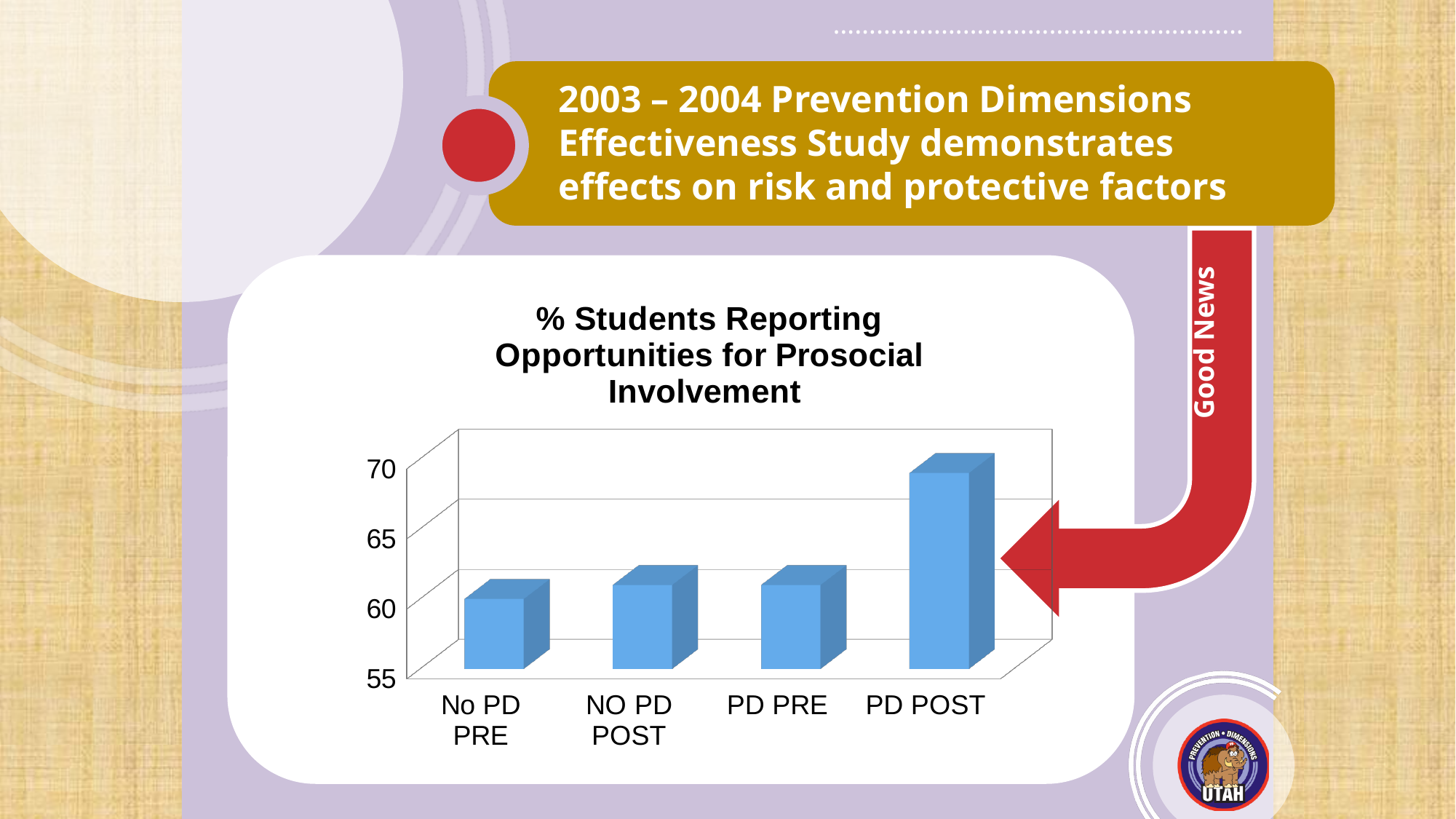
Which category has the lowest value in the chart? No PD PRE Which category has the highest value in the chart? PD POST How many categories are plotted on the x axis of the chart? 4 What kind of chart is shown on the slide? bar chart Is the value for No PD PRE greater or less than 65? less Which is larger, the value for PD POST or the value for PD PRE? PD POST What is the lowest value shown on the chart's vertical axis? 55 Is the value for NO PD POST greater or less than 55? greater Which is larger, the value for No PD PRE or the value for NO PD POST? NO PD POST What is the title of the chart? % Students Reporting Opportunities for Prosocial Involvement Is the value for PD PRE greater or less than 65? less